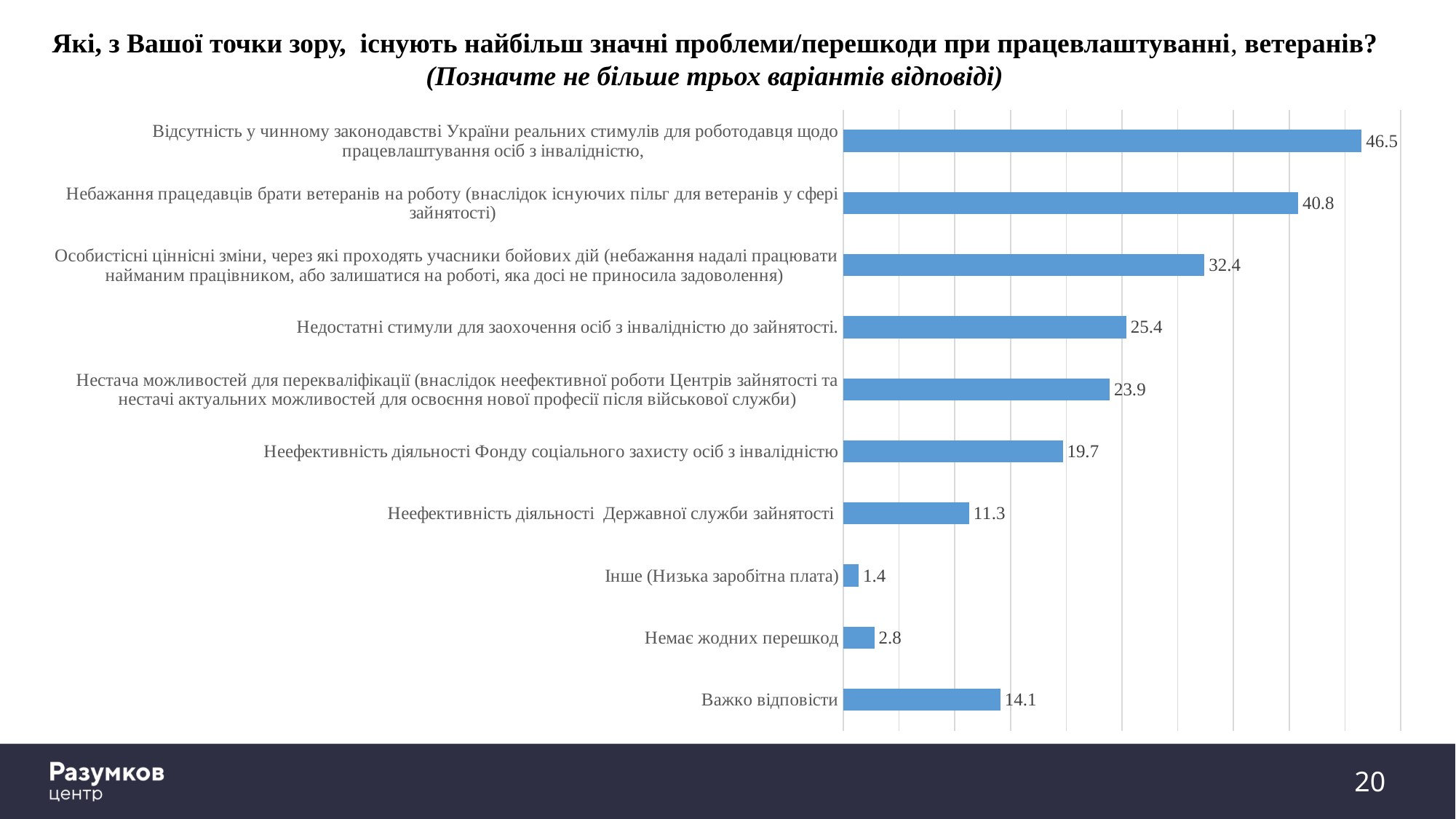
How many categories are shown in the chart? 10 What value is shown for "Важко відповісти"? 14.1 Which is larger: the value for "Немає жодних перешкод" or the value for "Інше (Низька заробітна плата)"? Немає жодних перешкод What is the difference between the values for "Відсутність у чинному законодавстві України реальних стимулів..." (46.5) and "Небажання працедавців брати ветеранів на роботу..." (40.8)? 5.7 Which category has the highest value? Відсутність у чинному законодавстві України реальних стимулів для роботодавця щодо працевлаштування осіб з інвалідністю Which is larger: the value for "Важко відповісти" or the value for "Неефективність діяльності Державної служби зайнятості"? Важко відповісти What value is shown for "Немає жодних перешкод"? 2.8 What type of chart is shown on the slide? Bar chart What value is shown for "Недостатні стимули для заохочення осіб з інвалідністю до зайнятості"? 25.4 What is the difference between the values for "Неефективність діяльності Фонду соціального захисту осіб з інвалідністю" and "Неефективність діяльності Державної служби зайнятості"? 8.4 What value is shown for "Неефективність діяльності Державної служби зайнятості"? 11.3 Which category has the lowest value? Інше (Низька заробітна плата)